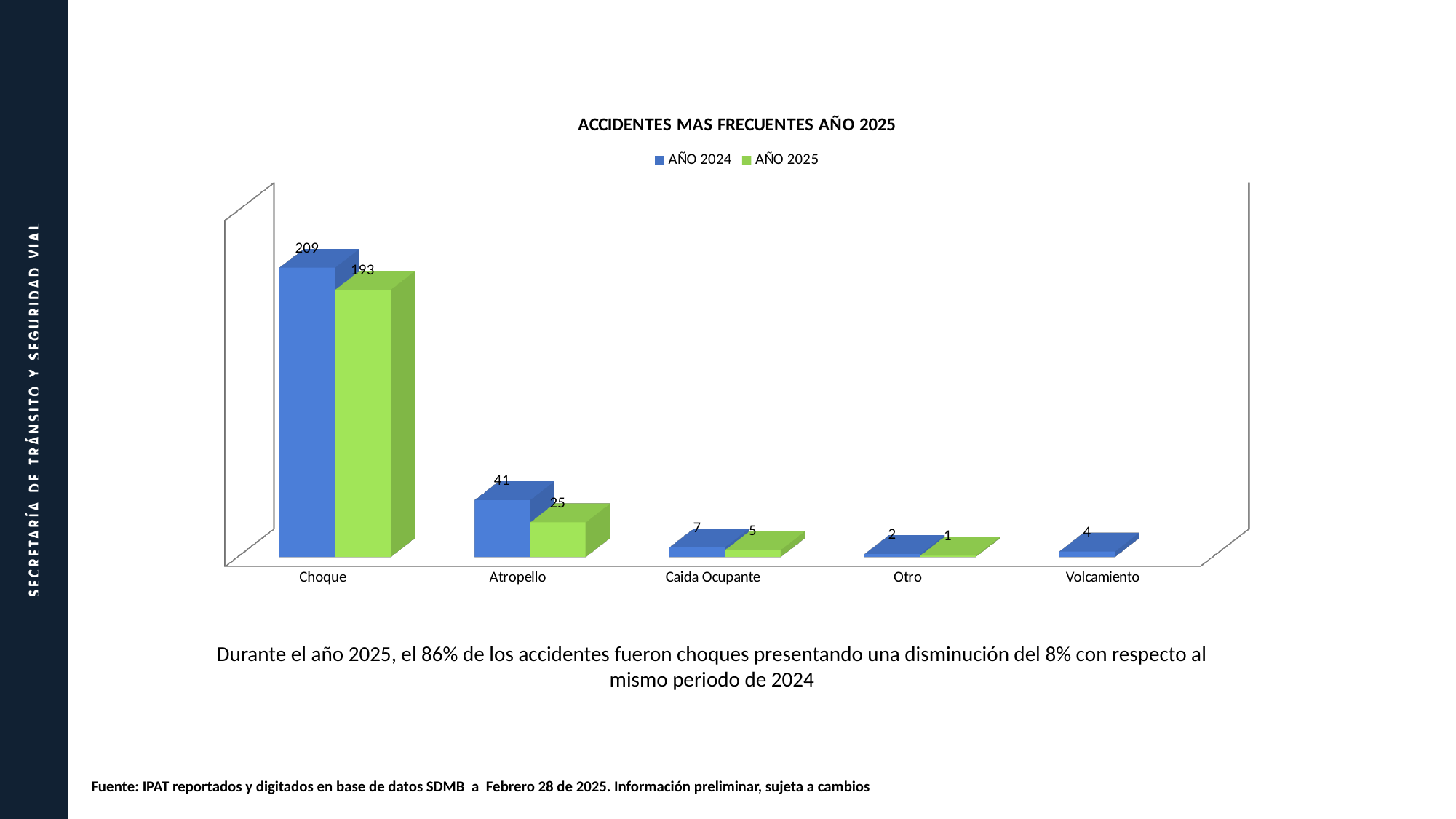
How many series does the legend list? 2 What is the value for Caida Ocupante in the AÑO 2024 series? 7 Which is larger for Atropello: the AÑO 2024 value or the AÑO 2025 value? AÑO 2024 Which category has the lowest value in the AÑO 2025 series? Otro What is the value for Choque in the AÑO 2025 series? 193 What is the value for Volcamiento in the AÑO 2024 series? 4 How many categories are shown on the x axis? 5 What is the difference between the AÑO 2024 and AÑO 2025 values for Atropello? 16 What is the difference between the AÑO 2024 and AÑO 2025 values for Choque? 16 Which category has the highest value in the AÑO 2025 series? Choque What is the value for Atropello in the AÑO 2025 series? 25 What is the value for Choque in the AÑO 2024 series? 209